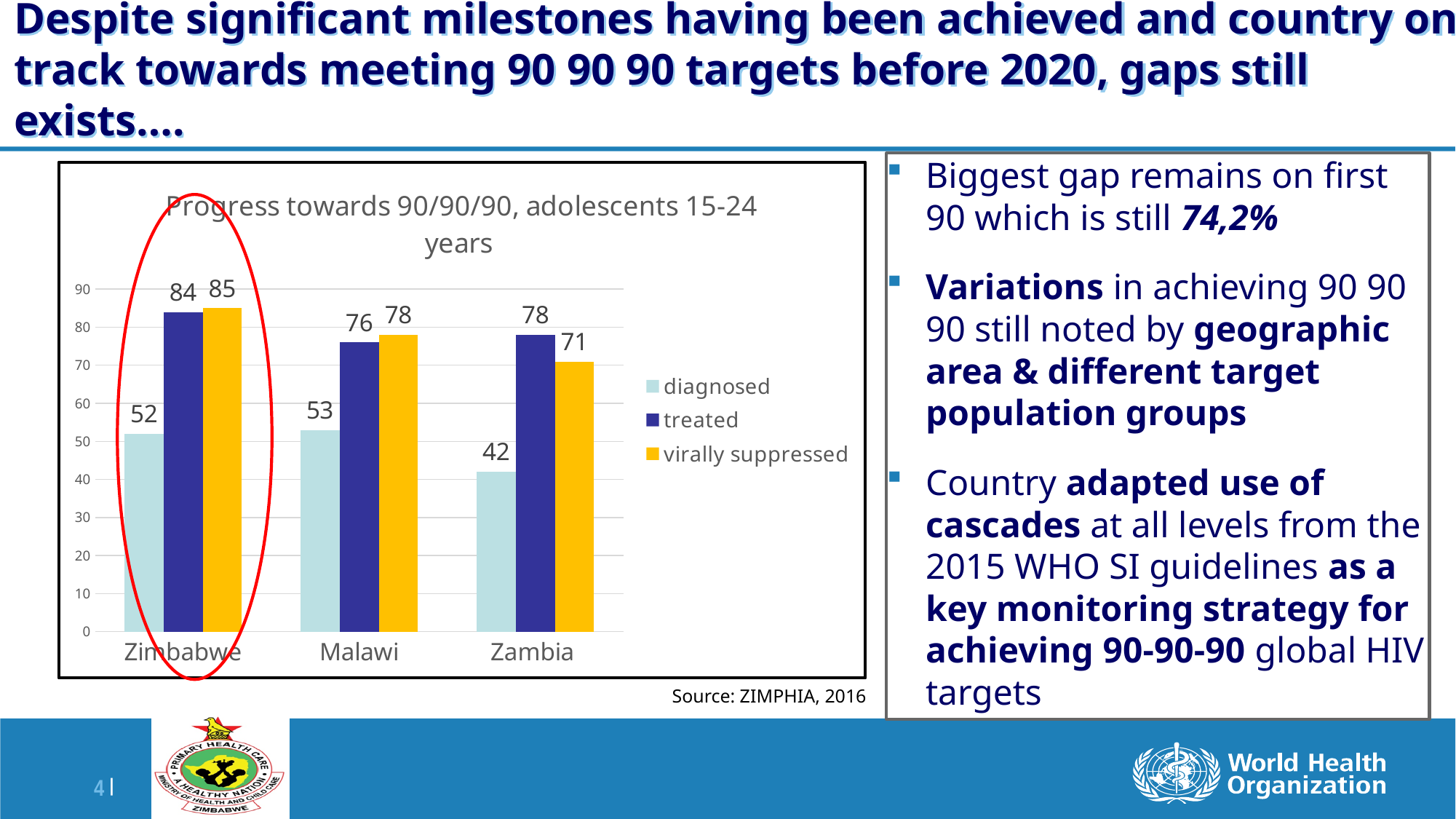
What is the treated value for Malawi? 76 Which country has the highest treated value? Zimbabwe Which country has the lowest diagnosed value? Zambia What is the difference between the treated and diagnosed values for Zambia? 36 How many series does the legend list? 3 What is the virally suppressed value for Zambia? 71 Which country is circled in red on the chart? Zimbabwe How many countries are shown on the x axis? 3 What is the diagnosed value for Zimbabwe? 52 What kind of chart is shown? bar chart Which is larger for Zambia, the treated value or the virally suppressed value? treated What is the title of the chart? Progress towards 90/90/90, adolescents 15-24 years